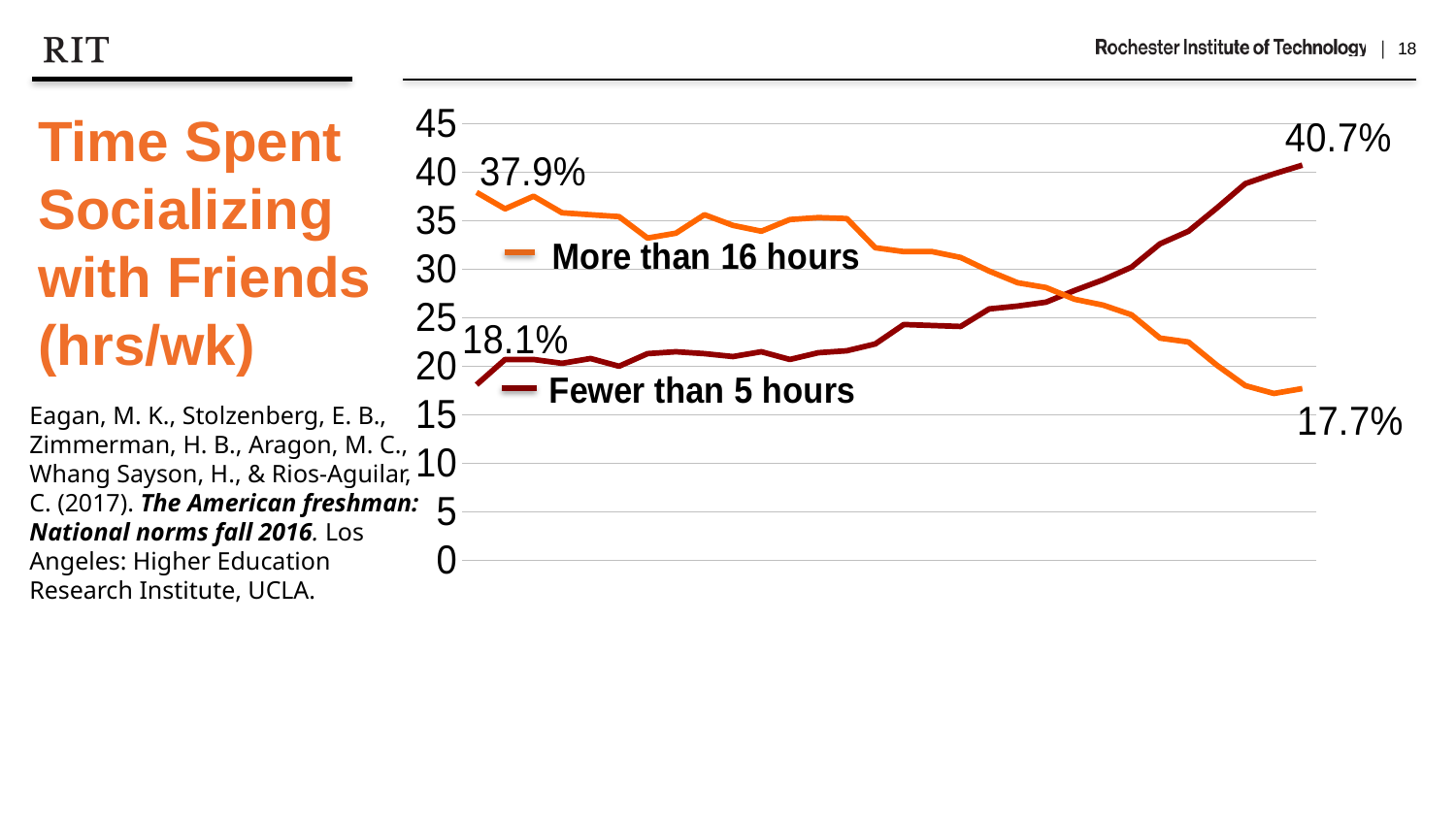
How many series are plotted on the chart? 2 Does the 'Fewer than 5 hours' line rise or fall over time? rise What kind of chart is shown on the slide? line chart Does the 'More than 16 hours' line rise or fall over time? fall By how many percentage points did the 'More than 16 hours' line fall from its first labeled value to its last? 20.2 What colour is the 'More than 16 hours' line? orange What is the final value shown for the 'Fewer than 5 hours' line? 40.7% At the end of the chart, which series has the higher value: 'More than 16 hours' or 'Fewer than 5 hours'? Fewer than 5 hours What is the starting value shown for the 'Fewer than 5 hours' line? 18.1% By how many percentage points did the 'Fewer than 5 hours' line rise from its first labeled value to its last? 22.6 What is the starting value shown for the 'More than 16 hours' line? 37.9% What is the final value shown for the 'More than 16 hours' line? 17.7%